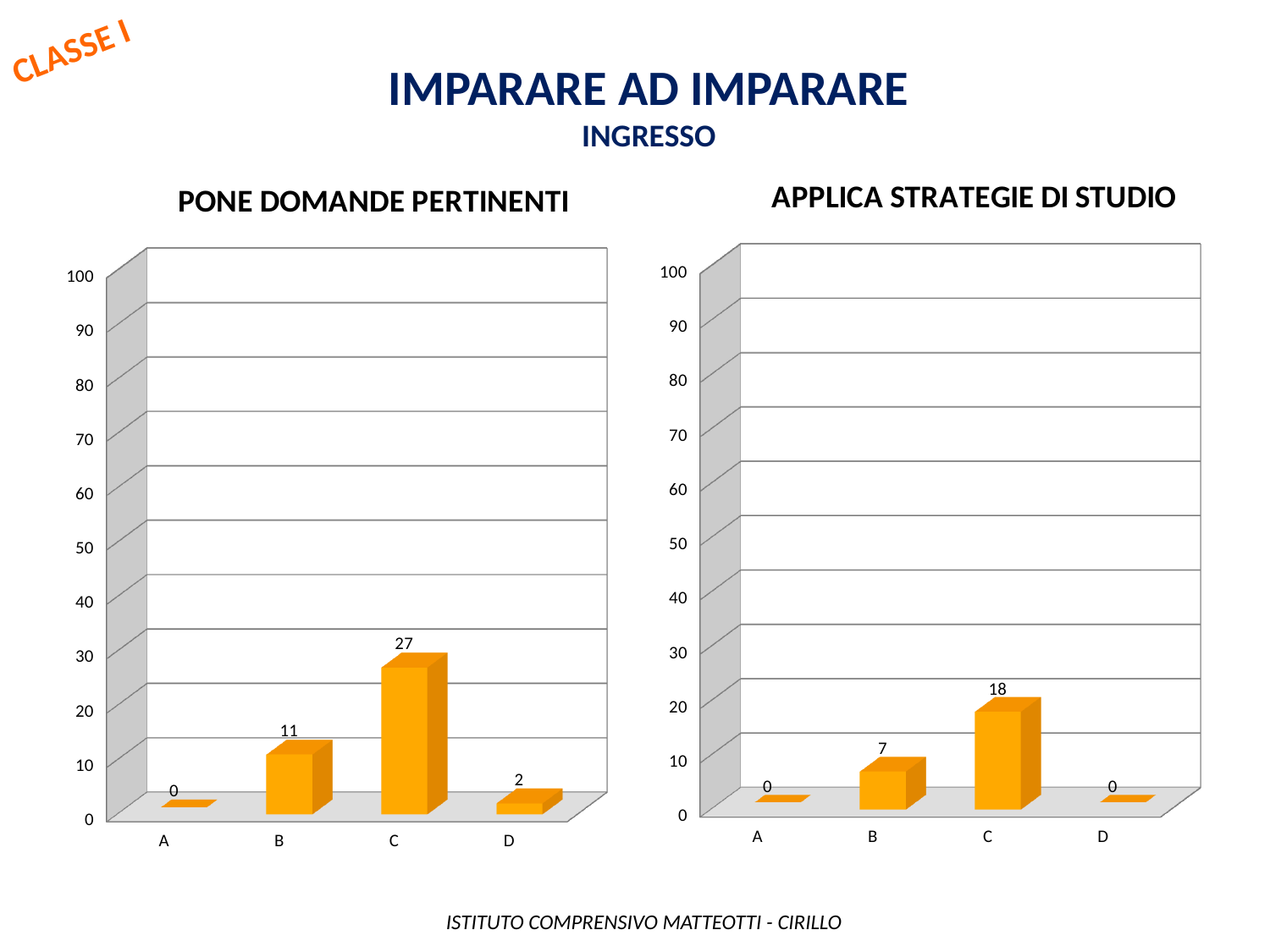
In the 'PONE DOMANDE PERTINENTI' chart, what is the value for category B? 11 In the 'PONE DOMANDE PERTINENTI' chart, which category has the highest value? C What kind of chart is the 'PONE DOMANDE PERTINENTI' chart? bar chart Which is larger: the value for C in the 'PONE DOMANDE PERTINENTI' chart or the value for C in the 'APPLICA STRATEGIE DI STUDIO' chart? PONE DOMANDE PERTINENTI In the 'PONE DOMANDE PERTINENTI' chart, is the value for C greater or less than 20? greater In the 'APPLICA STRATEGIE DI STUDIO' chart, what is the value for category B? 7 In the 'PONE DOMANDE PERTINENTI' chart, what is the value for category C? 27 In the 'PONE DOMANDE PERTINENTI' chart, what is the difference between the values for C and B? 16 In the 'APPLICA STRATEGIE DI STUDIO' chart, what is the value for category C? 18 How many categories are shown in the 'APPLICA STRATEGIE DI STUDIO' chart? 4 In the 'APPLICA STRATEGIE DI STUDIO' chart, which category has the lowest value? A and D In the 'APPLICA STRATEGIE DI STUDIO' chart, what is the difference between the values for C and B? 11